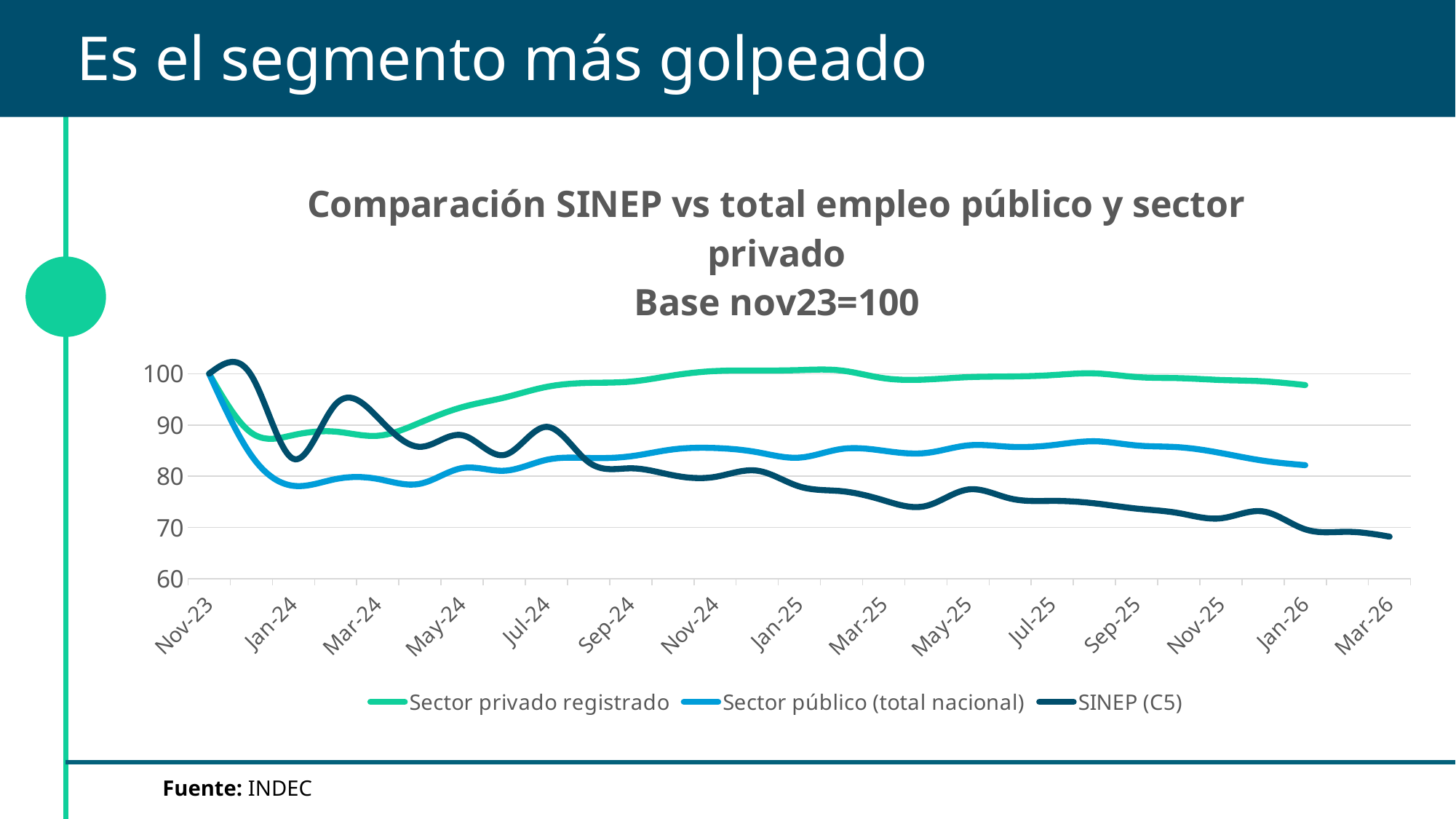
At Jan-26, which is larger: Sector público (total nacional) or SINEP (C5)? Sector público (total nacional) Does the SINEP (C5) series generally rise or fall from Nov-23 to Mar-26? Fall Which series has the highest value at Jan-26? Sector privado registrado What kind of chart is shown on the slide? Line chart Is the value for Sector privado registrado at Jan-26 greater or less than 100? less Is the value for Sector público (total nacional) at Sep-25 greater or less than 80? greater What is the value of all three series at Nov-23, the base period? 100 Is the value for SINEP (C5) at Mar-26 greater or less than 70? less How many series does the legend list? 3 What source is cited for the chart data? INDEC Which series has the lowest value at the end of the period (Mar-26)? SINEP (C5)